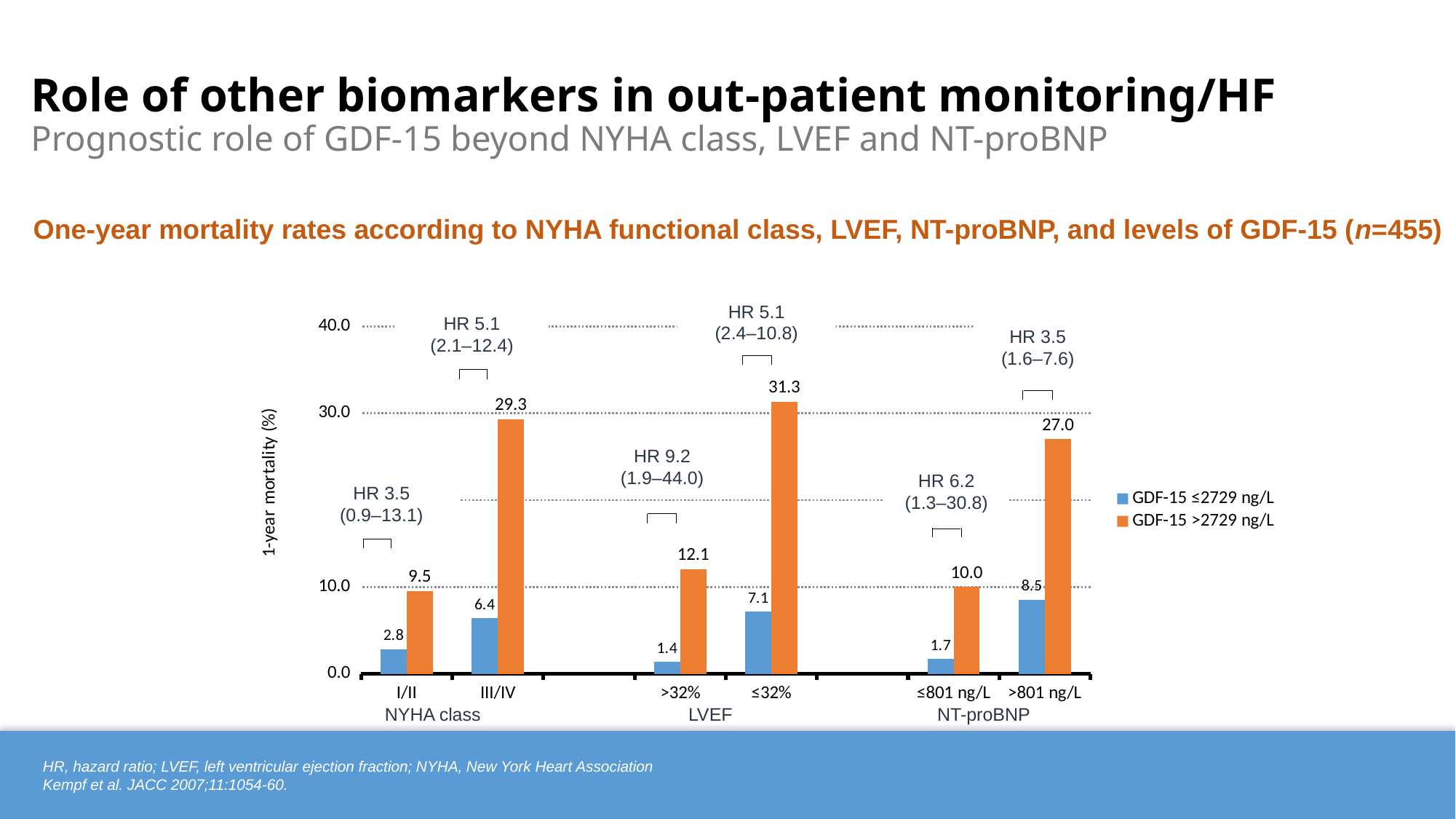
What is the difference in 1-year mortality between GDF-15 >2729 ng/L and GDF-15 ≤2729 ng/L in NYHA class I/II? 6.7 What is the 1-year mortality for GDF-15 >2729 ng/L in the NT-proBNP >801 ng/L group? 27.0 Which is larger: the GDF-15 ≤2729 ng/L value for NT-proBNP >801 ng/L or for LVEF ≤32%? NT-proBNP >801 ng/L Which category has the lowest 1-year mortality for GDF-15 ≤2729 ng/L? >32% Which category has the highest 1-year mortality for GDF-15 >2729 ng/L? ≤32% Is the value for GDF-15 >2729 ng/L in the LVEF ≤32% group greater or less than 30.0? greater What kind of chart is shown on the slide? Bar chart What is the 1-year mortality for GDF-15 ≤2729 ng/L in the LVEF >32% group? 1.4 How many categories are shown on the x axis? 6 What is the label of the y axis? 1-year mortality (%) What is the 1-year mortality for GDF-15 >2729 ng/L in NYHA class III/IV? 29.3 How many series does the legend list? 2